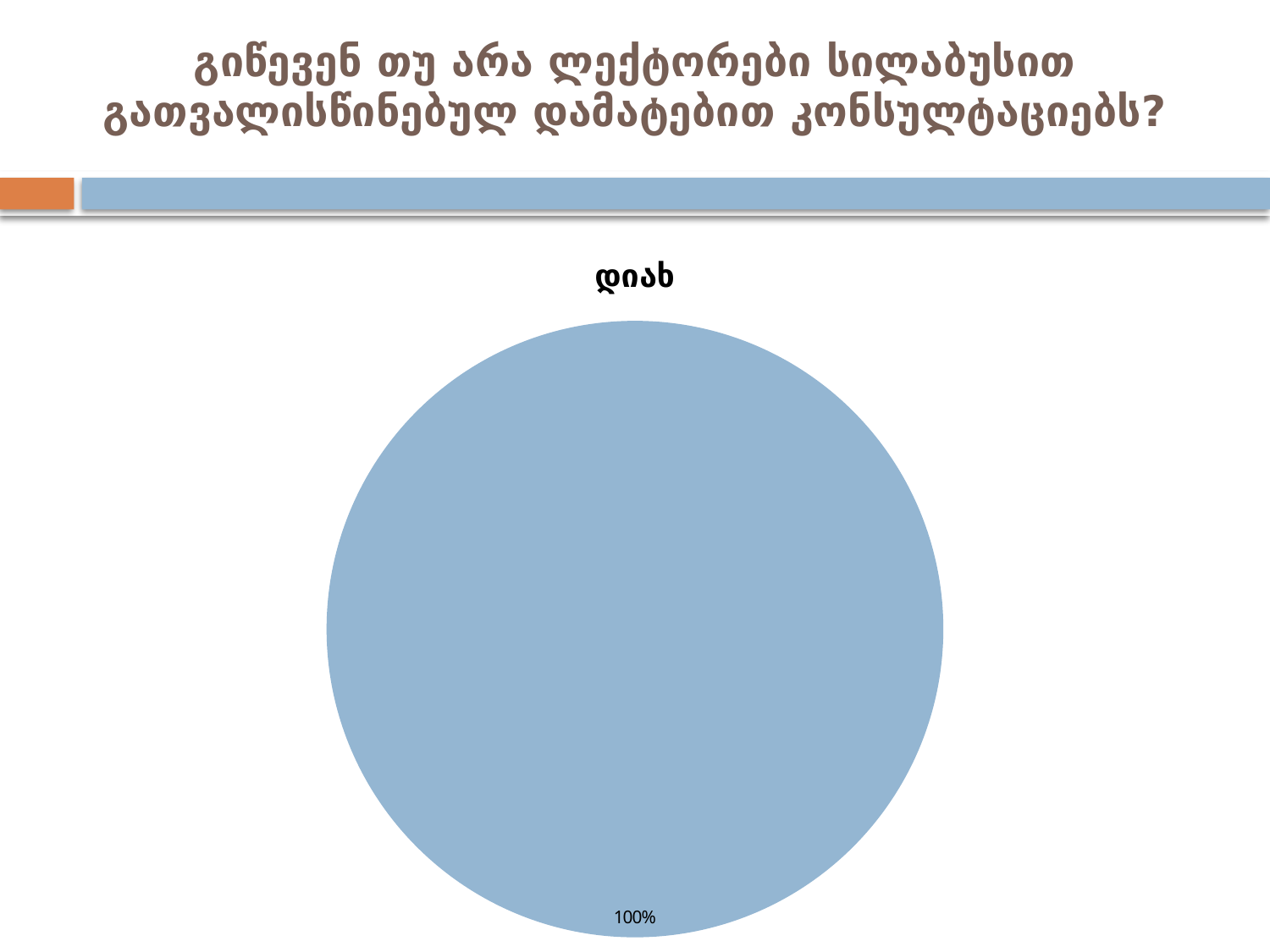
How many slices does the pie chart have? 1 What value is printed as the data label on the pie chart? 100% What share of the pie does the "დიახ" slice take? 100% What colour is the pie chart slice? light blue What is the title of the chart? დიახ What kind of chart is shown on the slide? pie chart Is the value shown on the pie chart greater or less than 50%? greater